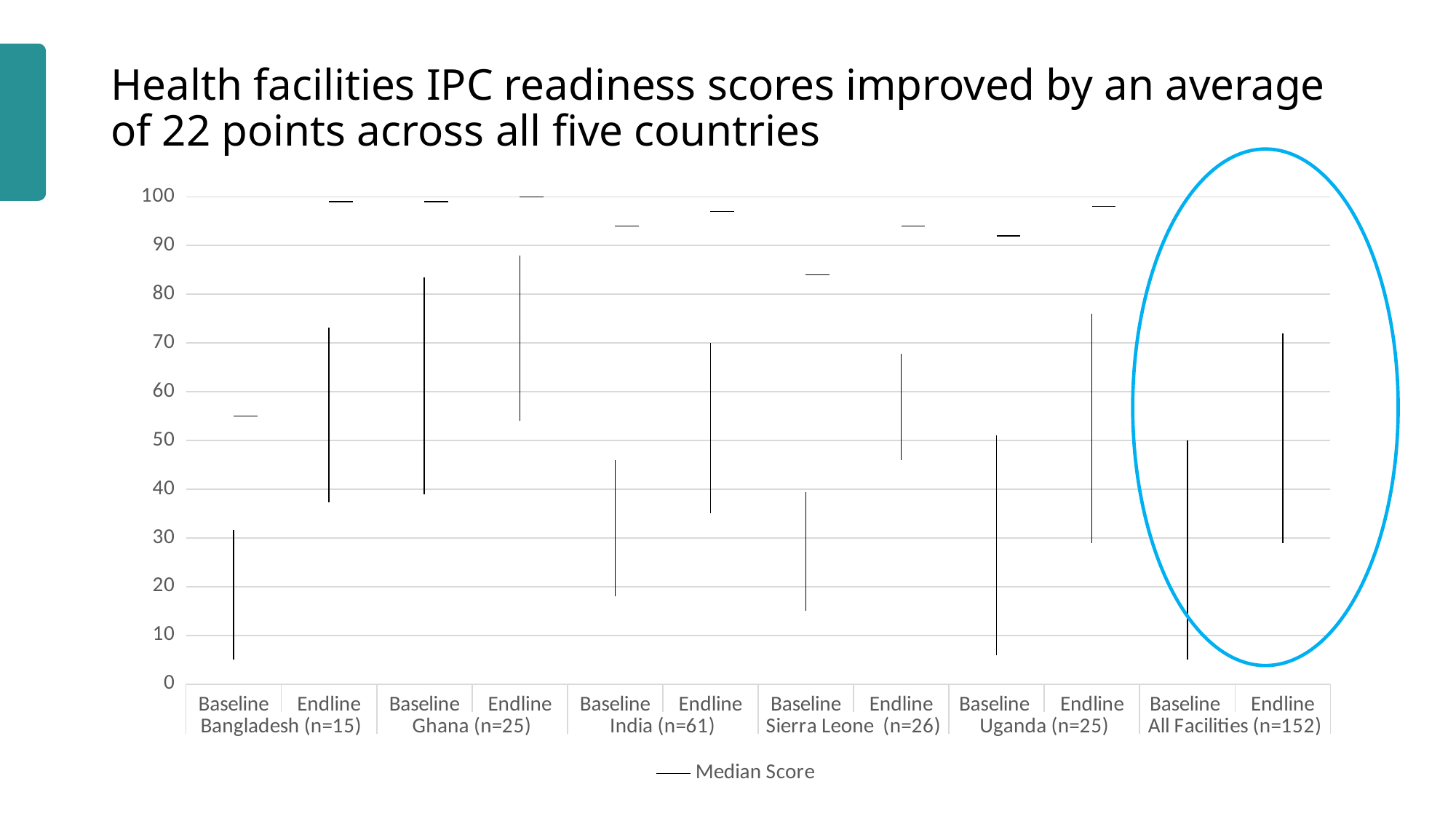
Is the Median Score marker for Sierra Leone Baseline greater or less than 90? less What is the title of the chart on the slide? Health facilities IPC readiness scores improved by an average of 22 points across all five countries Which category has the lowest Median Score marker on the chart? Bangladesh Baseline How many series does the chart legend list? 1 How many country groups (including All Facilities) are shown on the x axis? 6 Which has the higher Median Score marker, Sierra Leone Baseline or Sierra Leone Endline? Sierra Leone Endline Is the Median Score marker for Ghana Endline greater or less than 90? greater What is the sample size shown for India on the x axis? n=61 What is the name of the series shown in the legend? Median Score How many Baseline/Endline categories are plotted along the x axis? 12